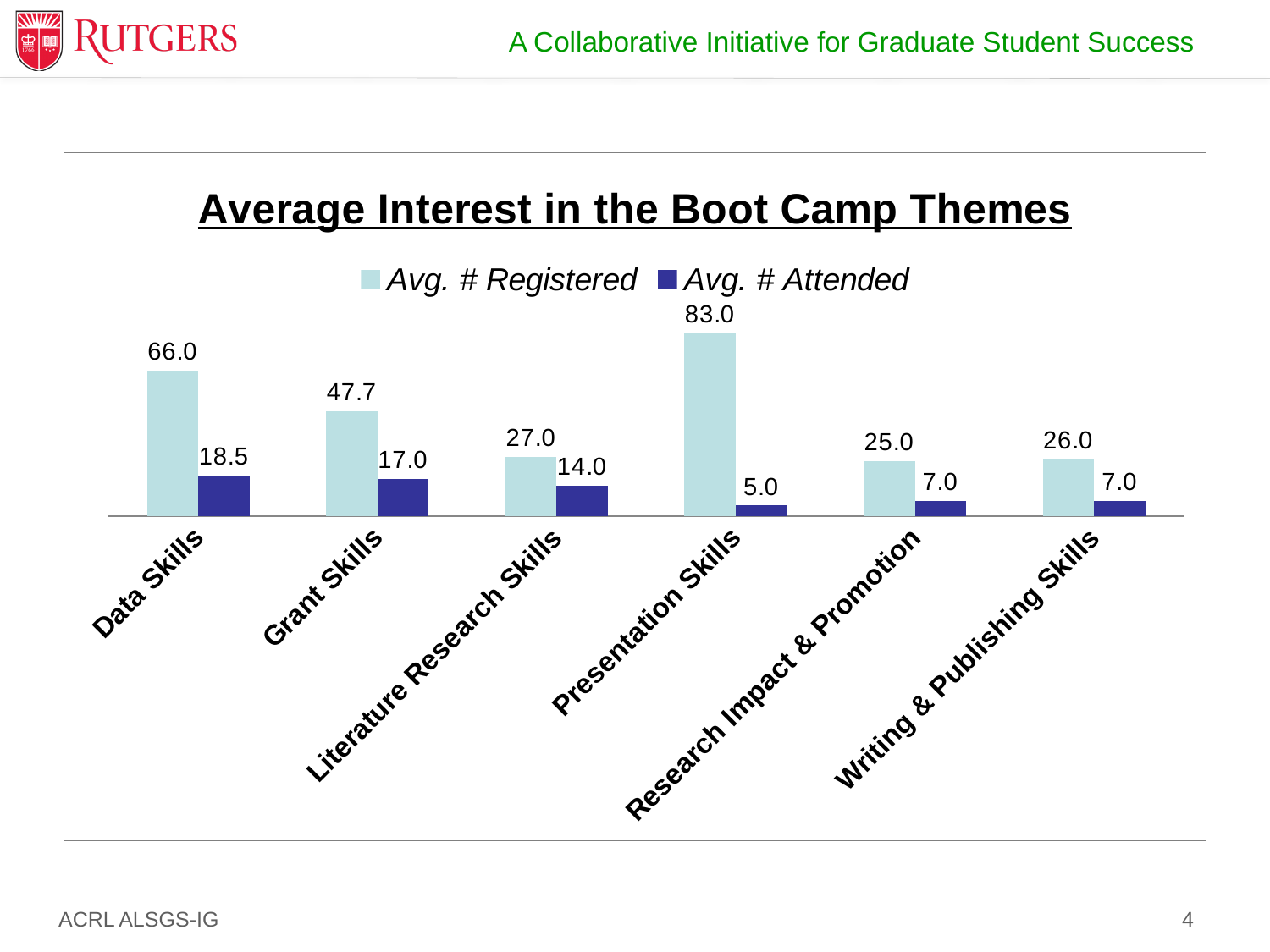
What is the difference between Avg. # Registered and Avg. # Attended for Data Skills? 47.5 What is the Avg. # Attended value for Writing & Publishing Skills? 7.0 Which theme has the lowest Avg. # Attended? Presentation Skills How many themes are shown on the x axis? 6 Which is larger, the Avg. # Attended for Grant Skills or for Literature Research Skills? Grant Skills What is the title of the chart? Average Interest in the Boot Camp Themes What is the Avg. # Attended value for Presentation Skills? 5.0 How many series does the legend list? 2 What is the Avg. # Registered value for Data Skills? 66.0 What kind of chart is shown? Bar chart Which theme has the highest Avg. # Registered? Presentation Skills What is the Avg. # Registered value for Grant Skills? 47.7